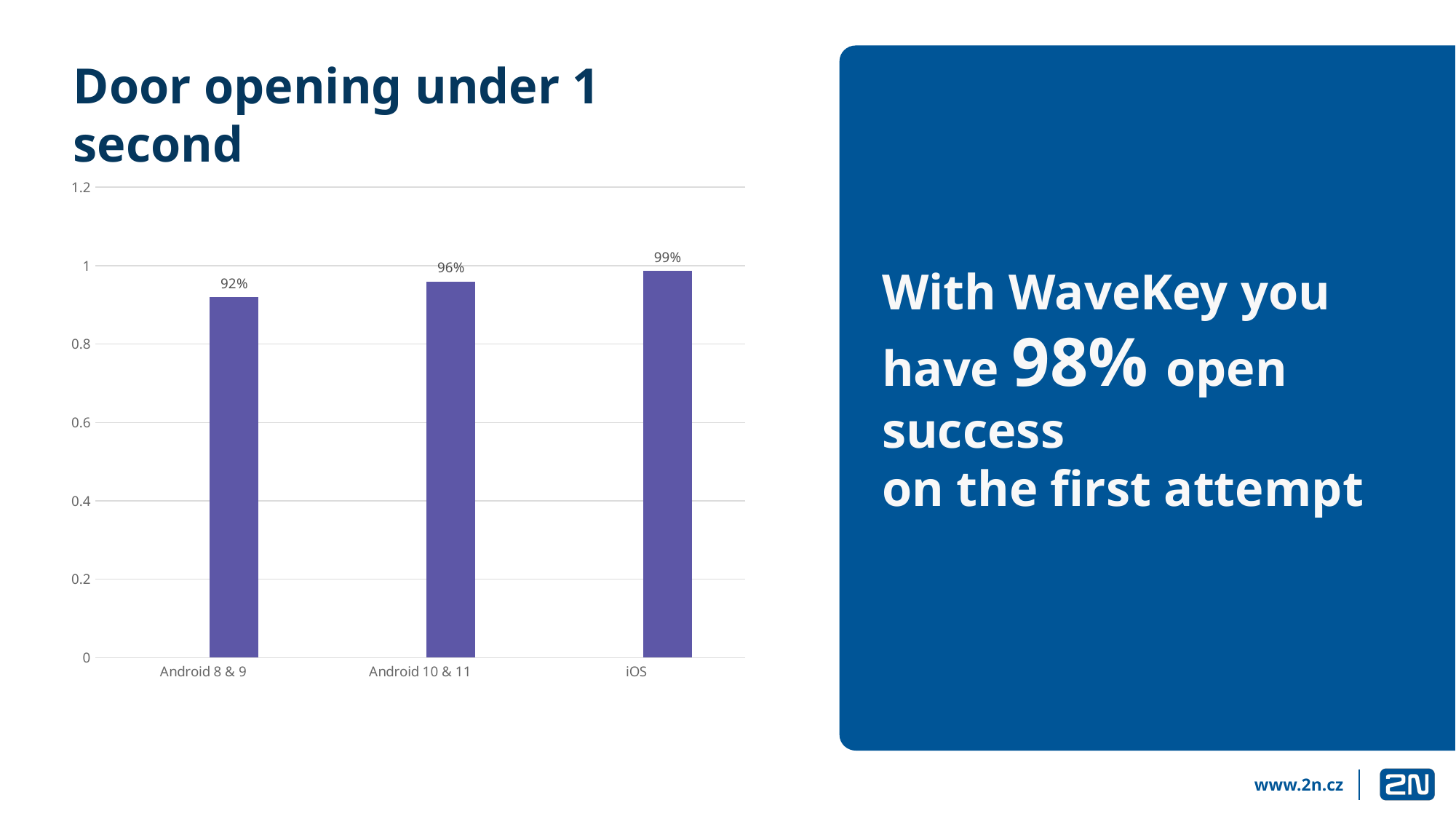
What kind of chart is shown on the slide? bar chart What is the difference between the values for iOS and Android 8 & 9? 7% What is the title of the chart? Door opening under 1 second Which category has the highest value? iOS Which is larger, the value for Android 10 & 11 or the value for Android 8 & 9? Android 10 & 11 Which category has the lowest value? Android 8 & 9 How many categories are shown in the chart? 3 What is the value for iOS? 99% What is the value for Android 8 & 9? 92% What is the value for Android 10 & 11? 96% Is the value for Android 8 & 9 greater or less than 0.8 on the axis? greater What is the difference between the values for Android 10 & 11 and Android 8 & 9? 4%